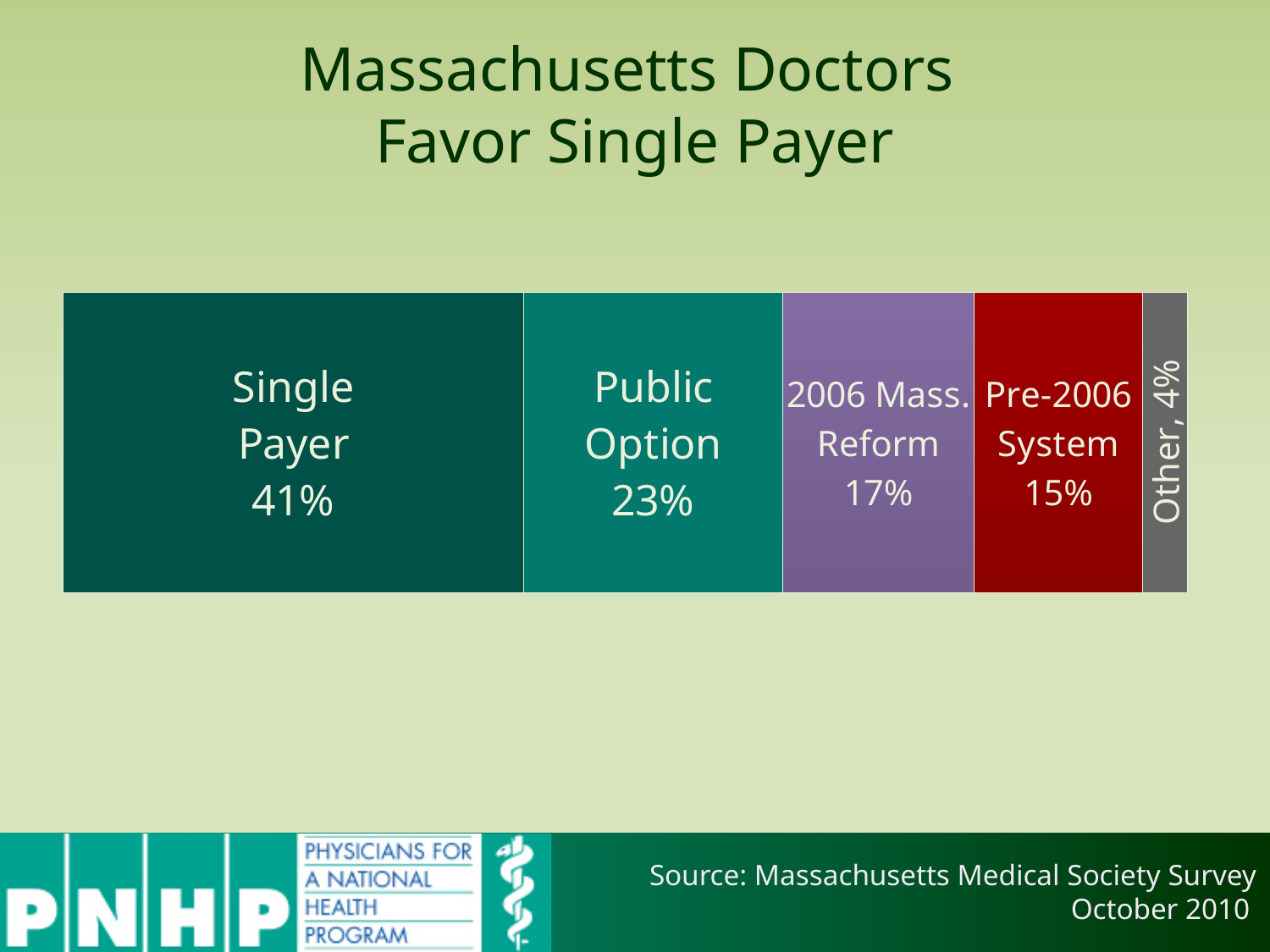
What is the title of the slide? Massachusetts Doctors Favor Single Payer What is the difference between the Single Payer share and the Public Option share? 18% What percentage of doctors favor the Pre-2006 System? 15% Which option has the smallest share of doctors? Other What is the total of all the segments in the stacked bar? 100% How many options are shown in the bar? 5 What percentage of doctors favor the Public Option? 23% Which option has the largest share of doctors? Single Payer What percentage is shown for Other? 4% What percentage of doctors favor the 2006 Mass. Reform? 17% What percentage of Massachusetts doctors favor Single Payer? 41% Which is larger, the share for 2006 Mass. Reform or the share for Pre-2006 System? 2006 Mass. Reform